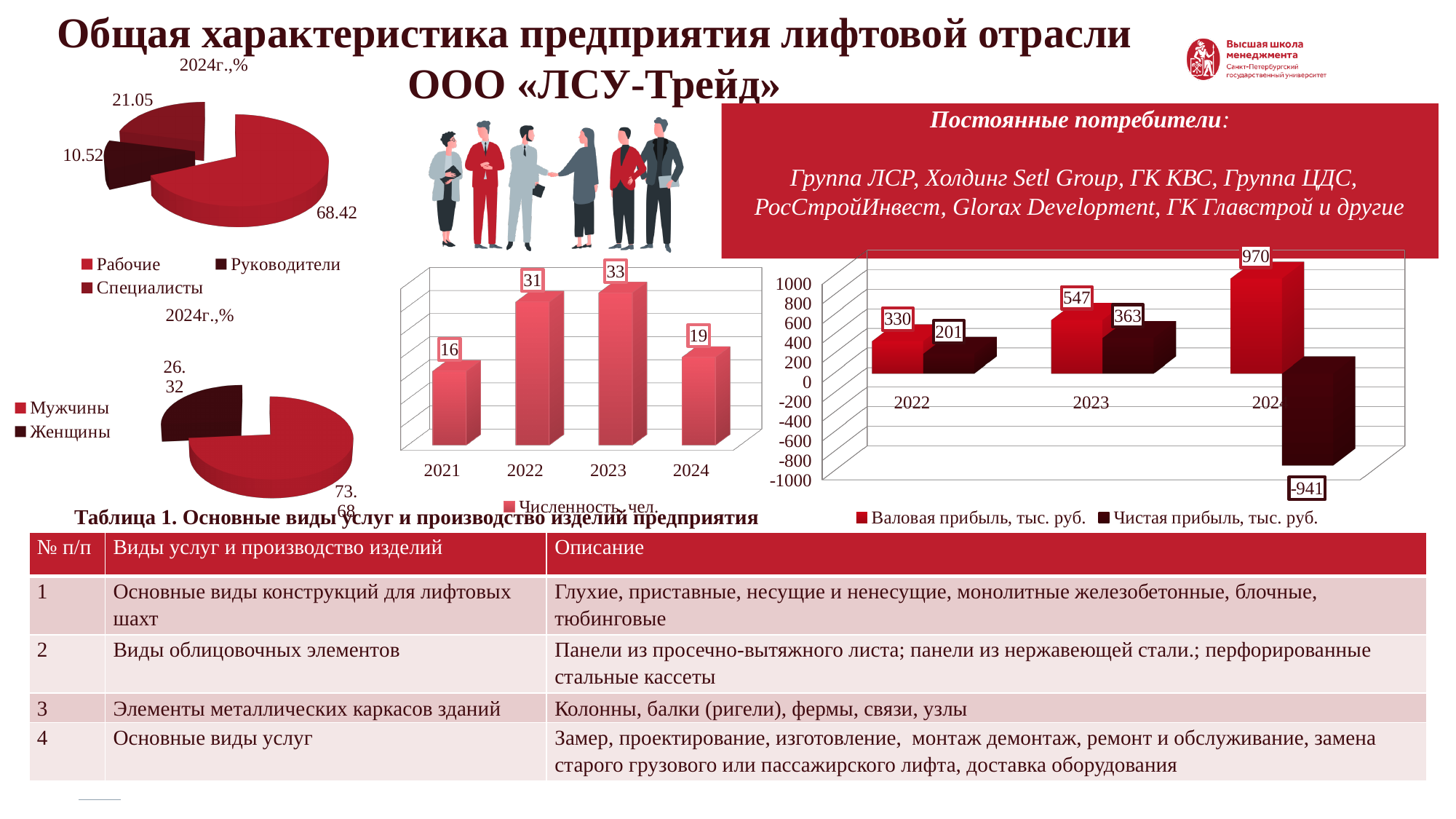
In the profit bar chart on the right, how many series does the legend list? 2 In the top-left pie chart (2024г.,%), what is the share for Рабочие? 68.42 In the headcount bar chart (Численность, чел.), which year has the lowest value? 2021 In the profit bar chart on the right, does Валовая прибыль rise or fall from 2022 to 2024? rise In the headcount bar chart (Численность, чел.), which year has the highest value? 2023 In the profit bar chart on the right, what is the difference between Валовая прибыль and Чистая прибыль in 2023? 184 In the headcount bar chart (Численность, чел.), what is the value for 2023? 33 In the profit bar chart on the right, what is the value of Валовая прибыль for 2024? 970 In the headcount bar chart (Численность, чел.), what is the difference between the values for 2022 and 2024? 12 In the headcount bar chart (Численность, чел.), how many years are shown on the x axis? 4 In the headcount bar chart (Численность, чел.), what is the value for 2021? 16 In the profit bar chart on the right, what is the value of Чистая прибыль for 2024? -941